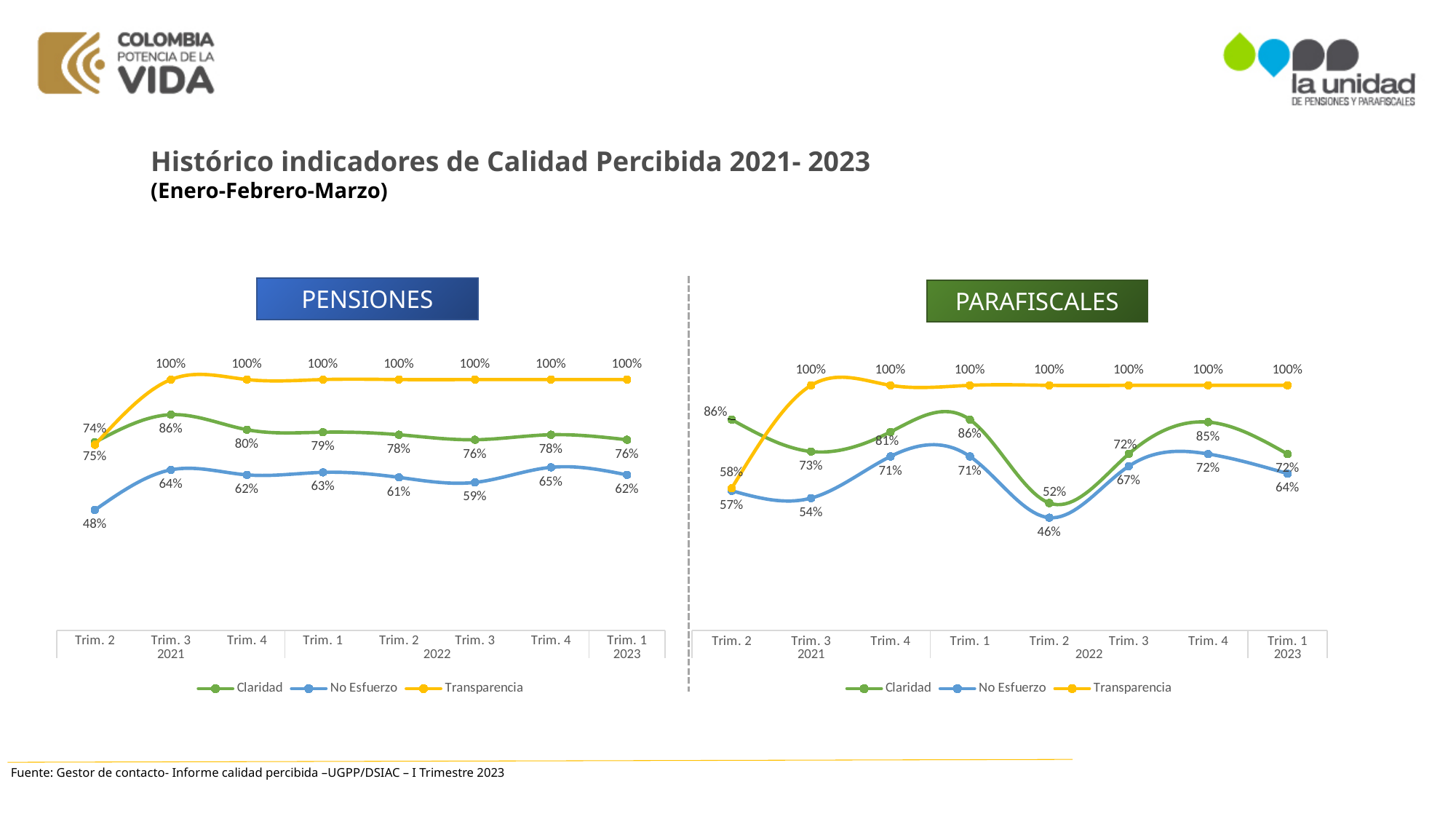
In the PARAFISCALES chart, what is the value of No Esfuerzo for Trim. 2 2022? 46% In the PARAFISCALES chart, which quarter has the lowest Claridad value? Trim. 2 2022 What kind of chart is the PARAFISCALES chart? Line chart In the PENSIONES chart, what is the value of No Esfuerzo for Trim. 3 2022? 59% In the PENSIONES chart, what is the difference between Claridad and No Esfuerzo for Trim. 1 2023? 14% In the PARAFISCALES chart, is Claridad for Trim. 4 2022 larger or smaller than Claridad for Trim. 1 2023? larger In the PENSIONES chart, which quarter has the lowest No Esfuerzo value? Trim. 2 2021 In the PENSIONES chart, what is the value of No Esfuerzo for Trim. 2 2021? 48% How many series does the legend of the PENSIONES chart list? 3 In the PENSIONES chart, what is the value of Claridad for Trim. 3 2021? 86% In the PARAFISCALES chart, what is the value of Transparencia for Trim. 2 2021? 58% In the PARAFISCALES chart, what is the difference between Claridad and No Esfuerzo for Trim. 3 2021? 19%